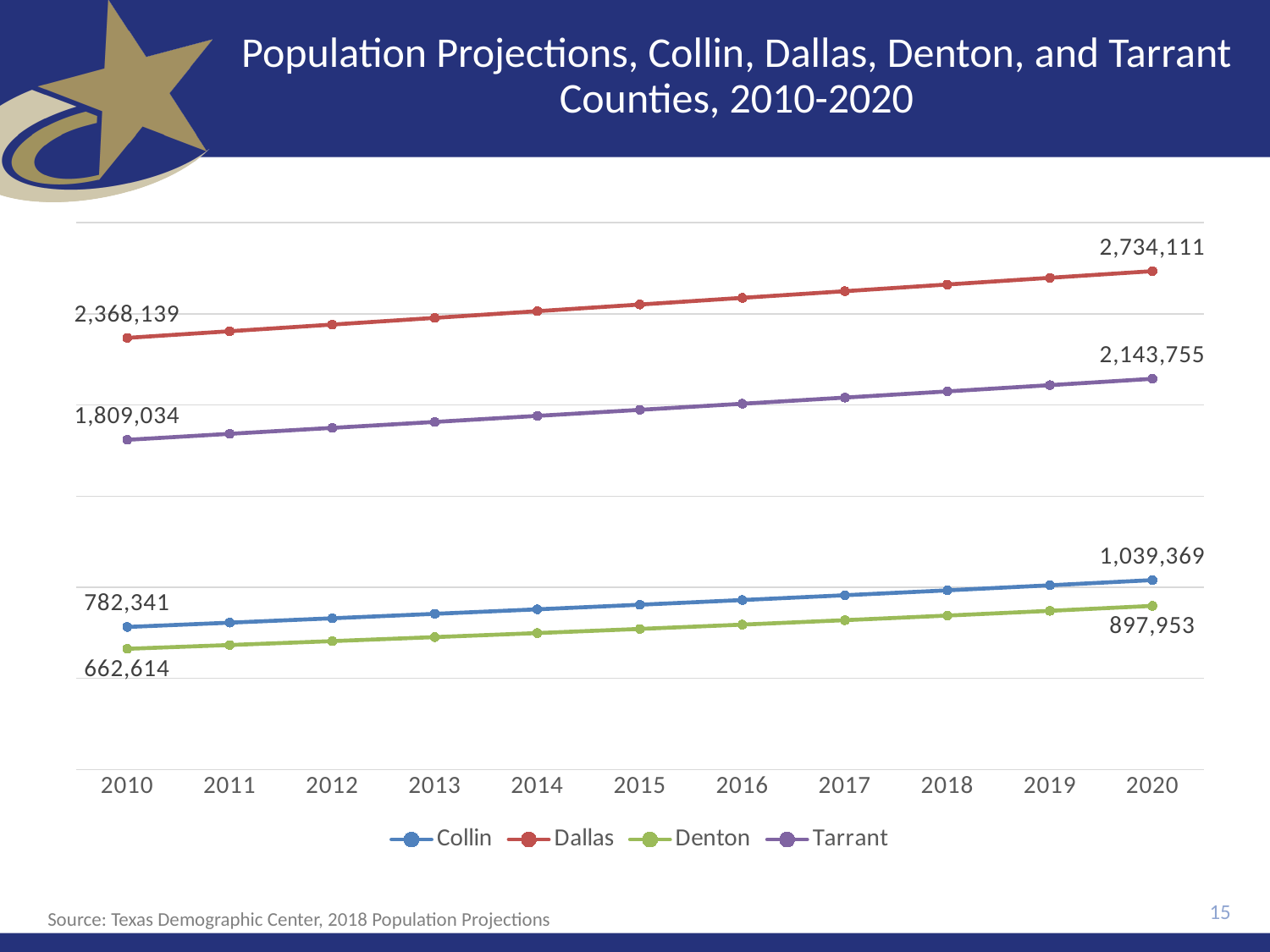
What is the projected population of Dallas County in 2020? 2,734,111 How many series does the legend list? 4 What is the projected population of Denton County in 2020? 897,953 How many years are shown on the x axis? 11 Which county has the lowest projected population in 2010? Denton Which is larger in 2020, the projected population of Tarrant County or Collin County? Tarrant County What is the projected population of Tarrant County in 2010? 1,809,034 By how much is Dallas County's population projected to grow from 2010 to 2020? 365,972 Which county has the highest projected population in 2020? Dallas What kind of chart is shown on the slide? Line chart What is the difference between the 2020 projected populations of Collin and Denton counties? 141,416 What is the projected population of Collin County in 2010? 782,341